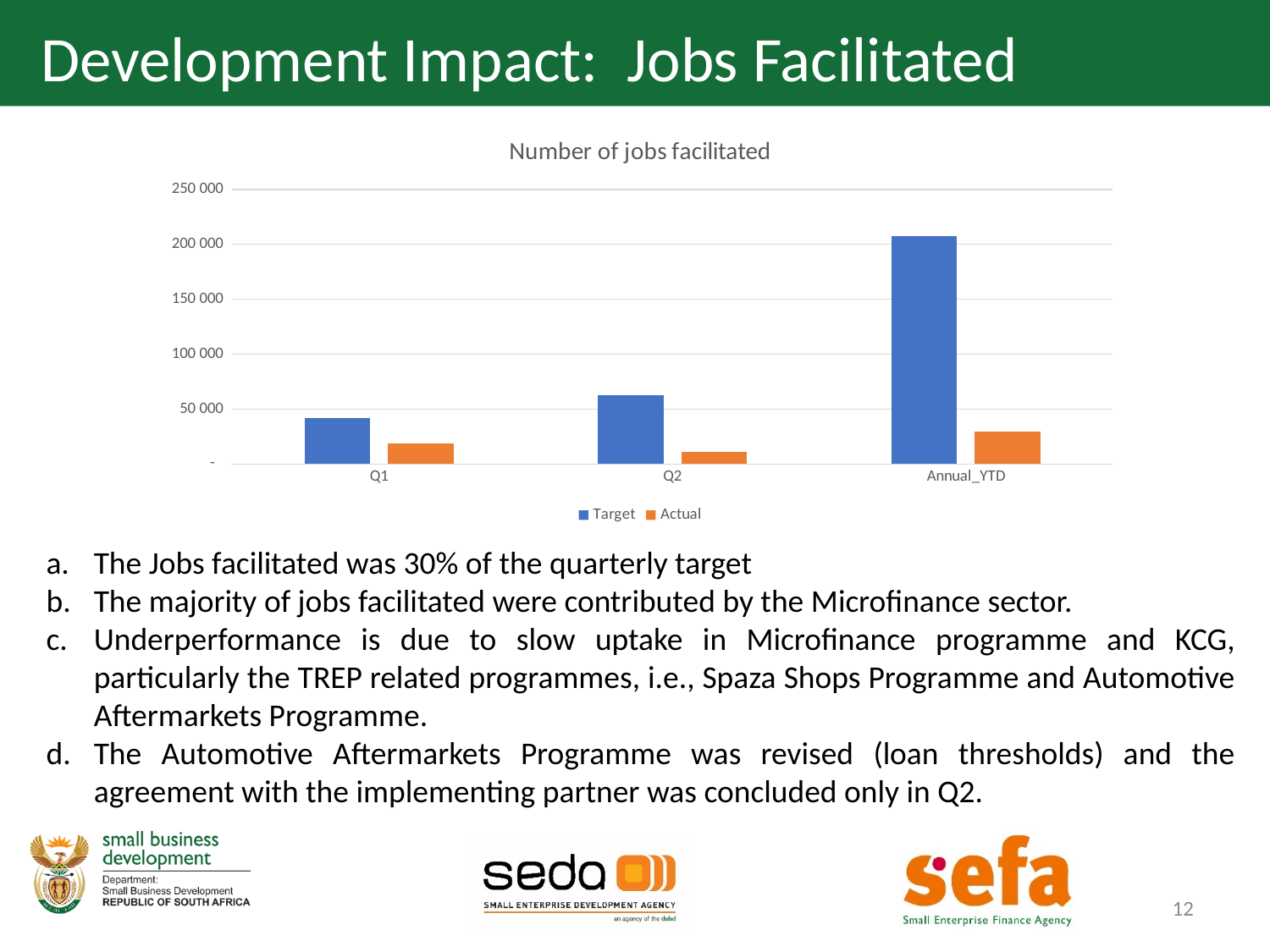
Is the Actual value for Annual_YTD greater or less than 50 000? less How many categories are shown on the x axis? 3 Which colour represents the Actual series in the legend? Orange Is the Target value for Q2 greater or less than 50 000? greater What is the title of the chart? Number of jobs facilitated Is the Target value for Q1 greater or less than 50 000? less How many series does the legend list? 2 Which category has the lowest Actual value? Q2 What type of chart is shown on the slide? Bar chart Which is larger, the Target value for Q1 or the Target value for Q2? Q2 Which category has the highest Target value? Annual_YTD